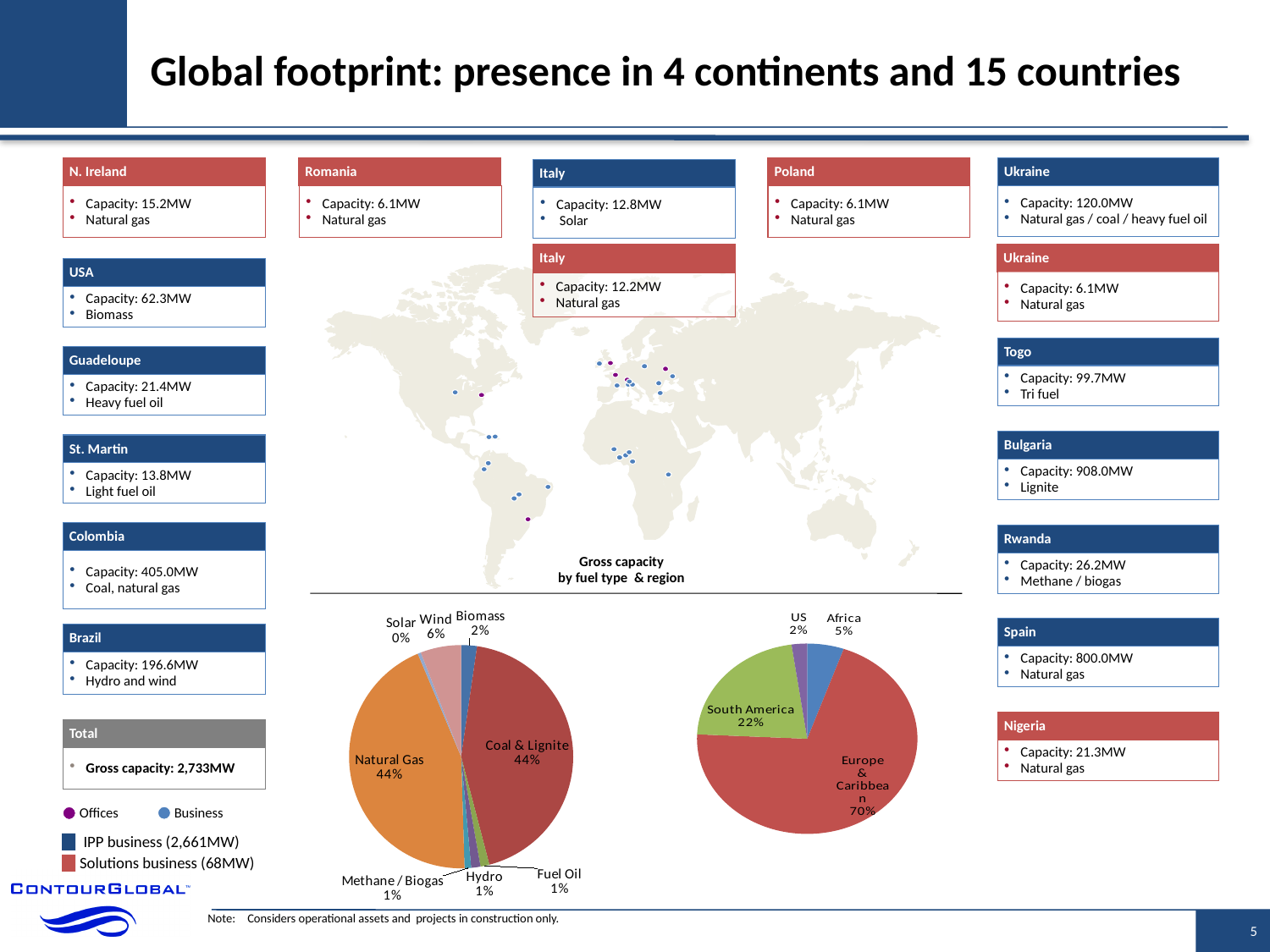
What kind of chart is used to show gross capacity by fuel type and by region? Pie chart How many fuel-type categories are shown in the left pie chart? 8 In the left pie chart (by fuel type), which fuel type has the smallest share? Solar In the right pie chart (by region), which region has the largest share of gross capacity? Europe & Caribbean In the left pie chart (by fuel type), what share of gross capacity is Natural Gas? 44% How many regions are shown in the right pie chart? 4 In the right pie chart (by region), what share of gross capacity is South America? 22% In the right pie chart (by region), what is the difference in percentage points between South America and Africa? 17 In the left pie chart (by fuel type), what is the difference in percentage points between Wind and Biomass? 4 In the right pie chart (by region), which region has the smallest share of gross capacity? US In the left pie chart (by fuel type), what share of gross capacity is Wind? 6% In the left pie chart (by fuel type), which has the larger share, Wind or Biomass? Wind